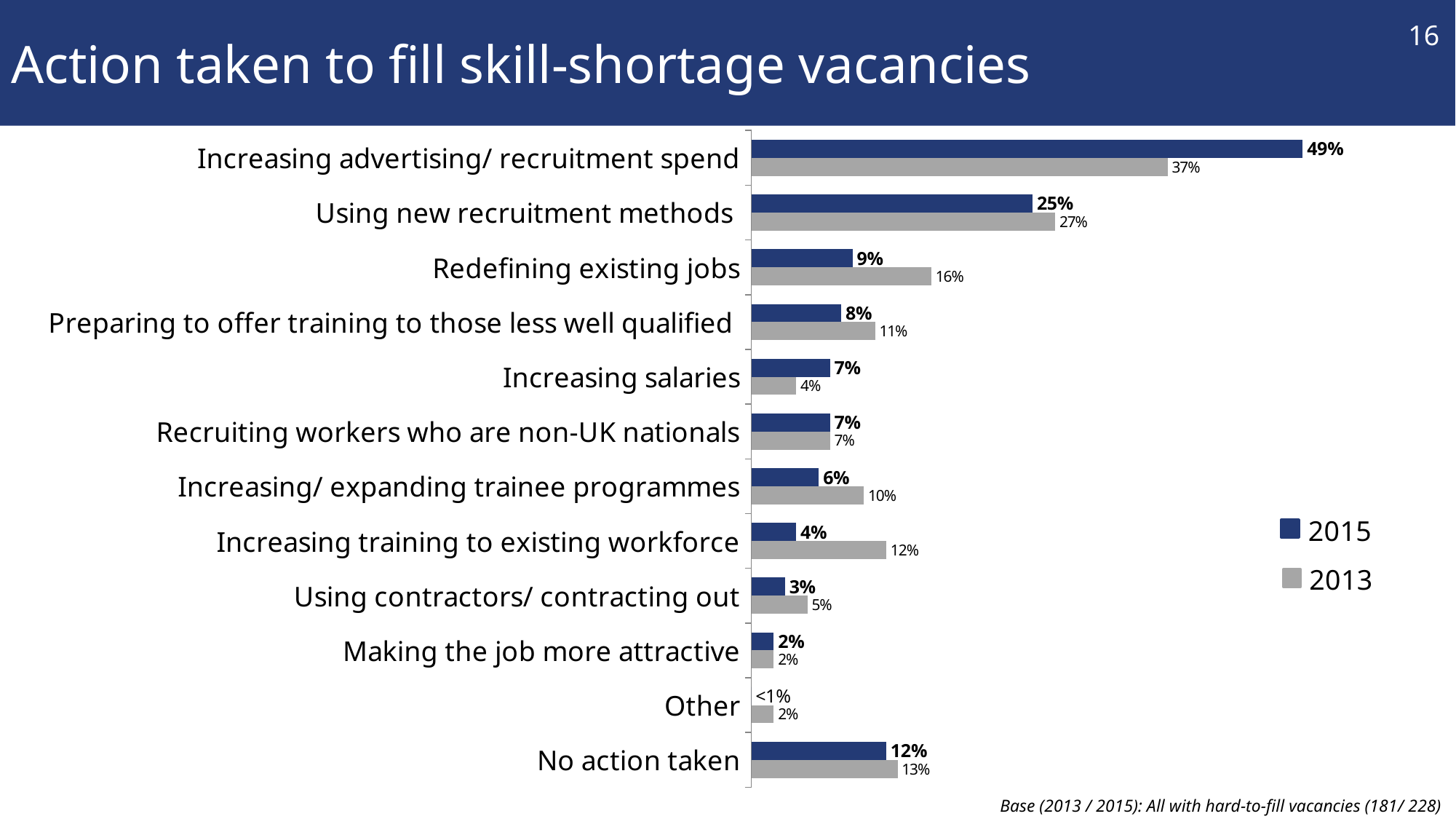
What is the 2015 value for No action taken? 12% What is the difference between the 2013 and 2015 values for Increasing training to existing workforce? 8% For Using new recruitment methods, which year has the larger value, 2015 or 2013? 2013 Which category has the highest 2015 value? Increasing advertising/ recruitment spend What is the 2013 value for Redefining existing jobs? 16% How many series does the legend list? 2 What is the 2015 value for Increasing advertising/ recruitment spend? 49% What is the difference between the 2015 and 2013 values for Increasing advertising/ recruitment spend? 12% Which category has the lowest 2015 value? Other How many categories are shown on the chart? 12 What is the 2013 value for Increasing training to existing workforce? 12% For Increasing salaries, which year has the larger value, 2015 or 2013? 2015